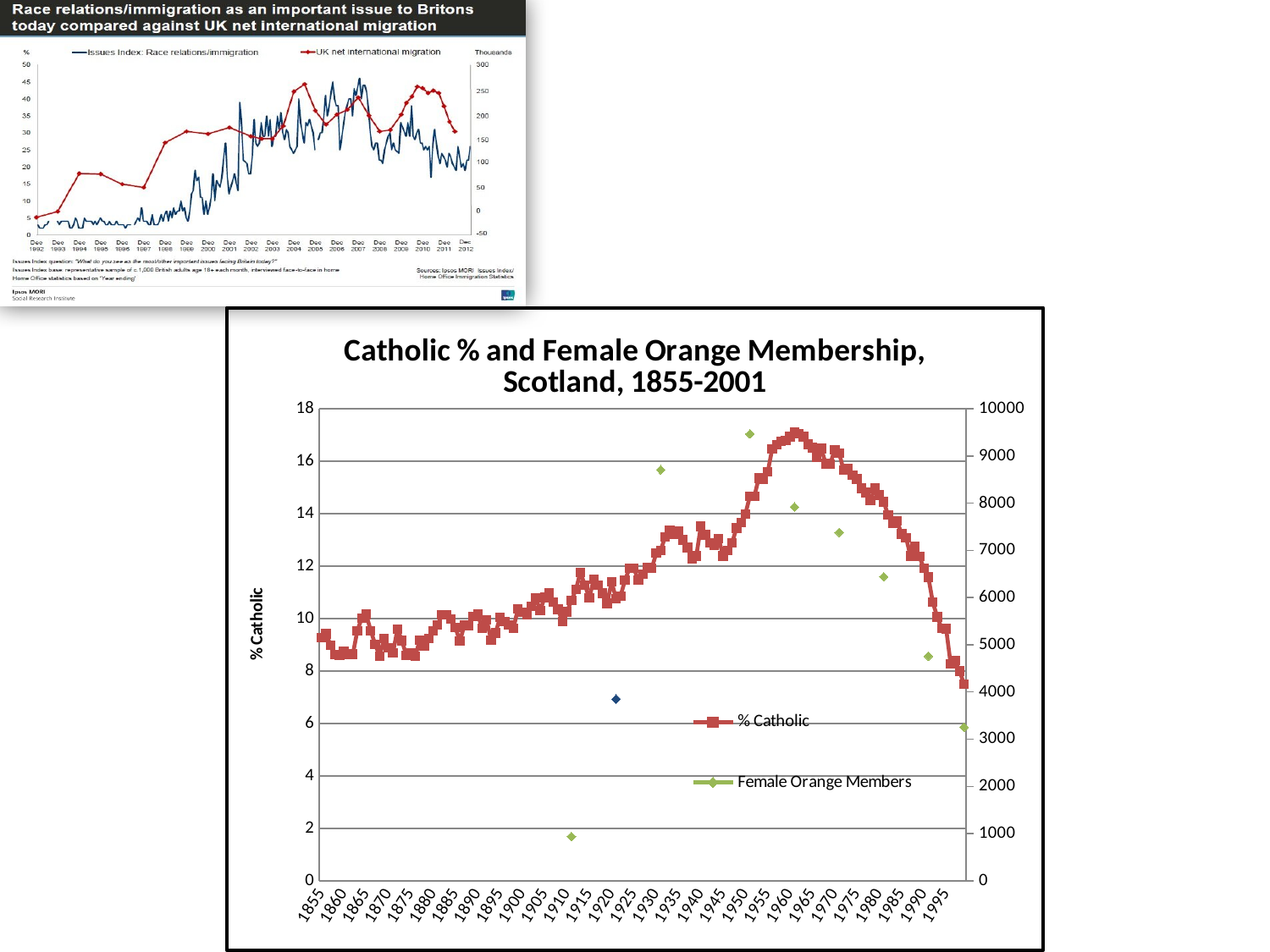
On the chart titled 'Catholic % and Female Orange Membership, Scotland, 1855-2001', how many series does the legend list? 2 On the chart titled 'Catholic % and Female Orange Membership, Scotland, 1855-2001', is the % Catholic value in 1855 greater or less than 10? less On the chart titled 'Catholic % and Female Orange Membership, Scotland, 1855-2001', does the % Catholic series generally rise or fall between 1900 and 1960? rise On the chart titled 'Catholic % and Female Orange Membership, Scotland, 1855-2001', what is the highest value shown on the right vertical axis? 10000 On the chart titled 'Catholic % and Female Orange Membership, Scotland, 1855-2001', what kind of chart is it? line chart On the chart titled 'Catholic % and Female Orange Membership, Scotland, 1855-2001', is the Female Orange Members value around 1950 greater or less than 9000? greater On the chart titled 'Catholic % and Female Orange Membership, Scotland, 1855-2001', does the % Catholic series rise or fall between 1965 and 2001? fall On the chart titled 'Catholic % and Female Orange Membership, Scotland, 1855-2001', what is the label of the left vertical axis? % Catholic On the chart titled 'Catholic % and Female Orange Membership, Scotland, 1855-2001', is the earliest Female Orange Members point (around 1912) greater or less than 1000? less On the small chart at the top left of the slide, how many series does the legend list? 2